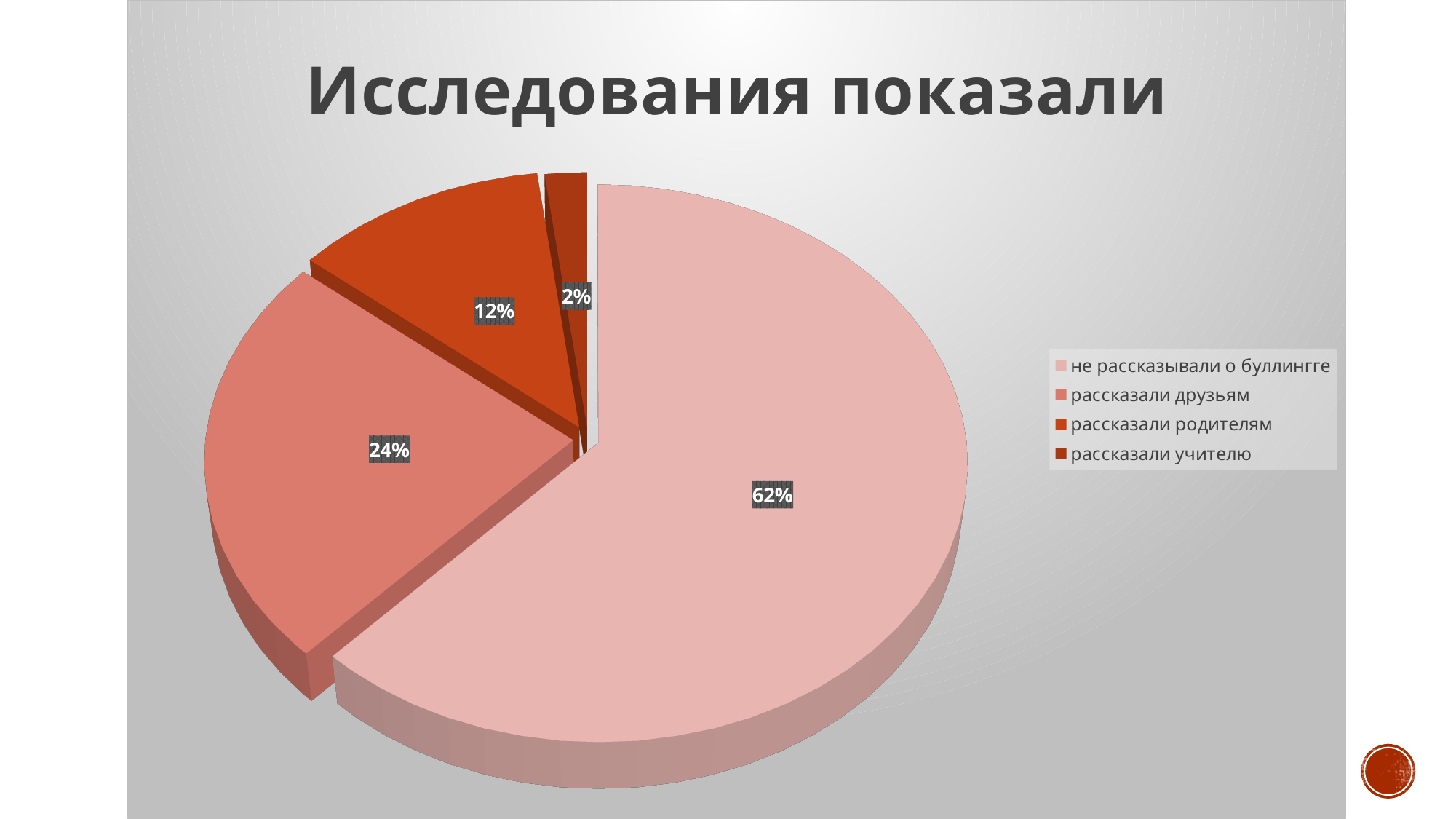
What kind of chart is shown on the slide? pie chart What is the value for 'рассказали учителю'? 2% What share of the pie is labelled 'не рассказывали о буллингге'? 62% How many slices does the pie chart have? 4 Which category has the smallest slice? рассказали учителю What is the title of the slide? Исследования показали Which is larger, 'рассказали родителям' or 'рассказали учителю'? рассказали родителям What is the value for 'рассказали друзьям'? 24% Which category has the largest slice? не рассказывали о буллингге How many entries does the legend list? 4 What is the value for 'рассказали родителям'? 12% What is the difference between 'рассказали друзьям' and 'рассказали родителям'? 12%